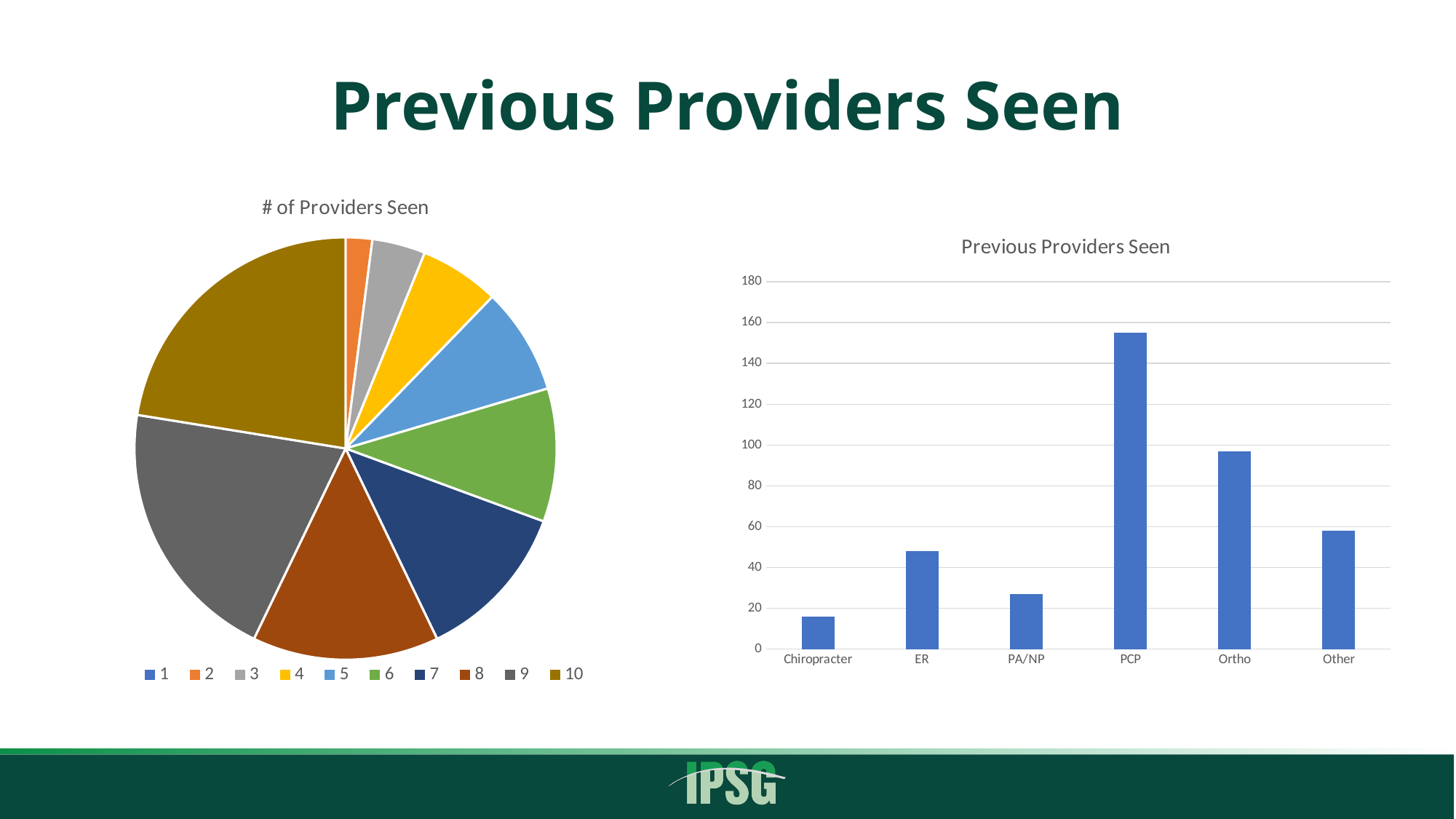
In the chart titled "Previous Providers Seen", what kind of chart is it? bar chart In the chart titled "Previous Providers Seen", is the value for Ortho greater or less than 100? less In the chart titled "# of Providers Seen", how many entries does the legend list? 10 In the chart titled "Previous Providers Seen", is the value for PCP greater or less than 140? greater In the chart titled "Previous Providers Seen", which category has the lowest value? Chiropracter In the chart titled "# of Providers Seen", which legend entry has the largest slice? 10 In the chart titled "Previous Providers Seen", how many categories are shown on the x axis? 6 In the chart titled "Previous Providers Seen", which is larger, the value for Other or the value for Ortho? Ortho In the chart titled "Previous Providers Seen", which is larger, the value for ER or the value for PA/NP? ER In the chart titled "Previous Providers Seen", which category has the highest value? PCP In the chart titled "# of Providers Seen", what kind of chart is it? pie chart In the chart titled "Previous Providers Seen", is the value for Chiropracter greater or less than 20? less